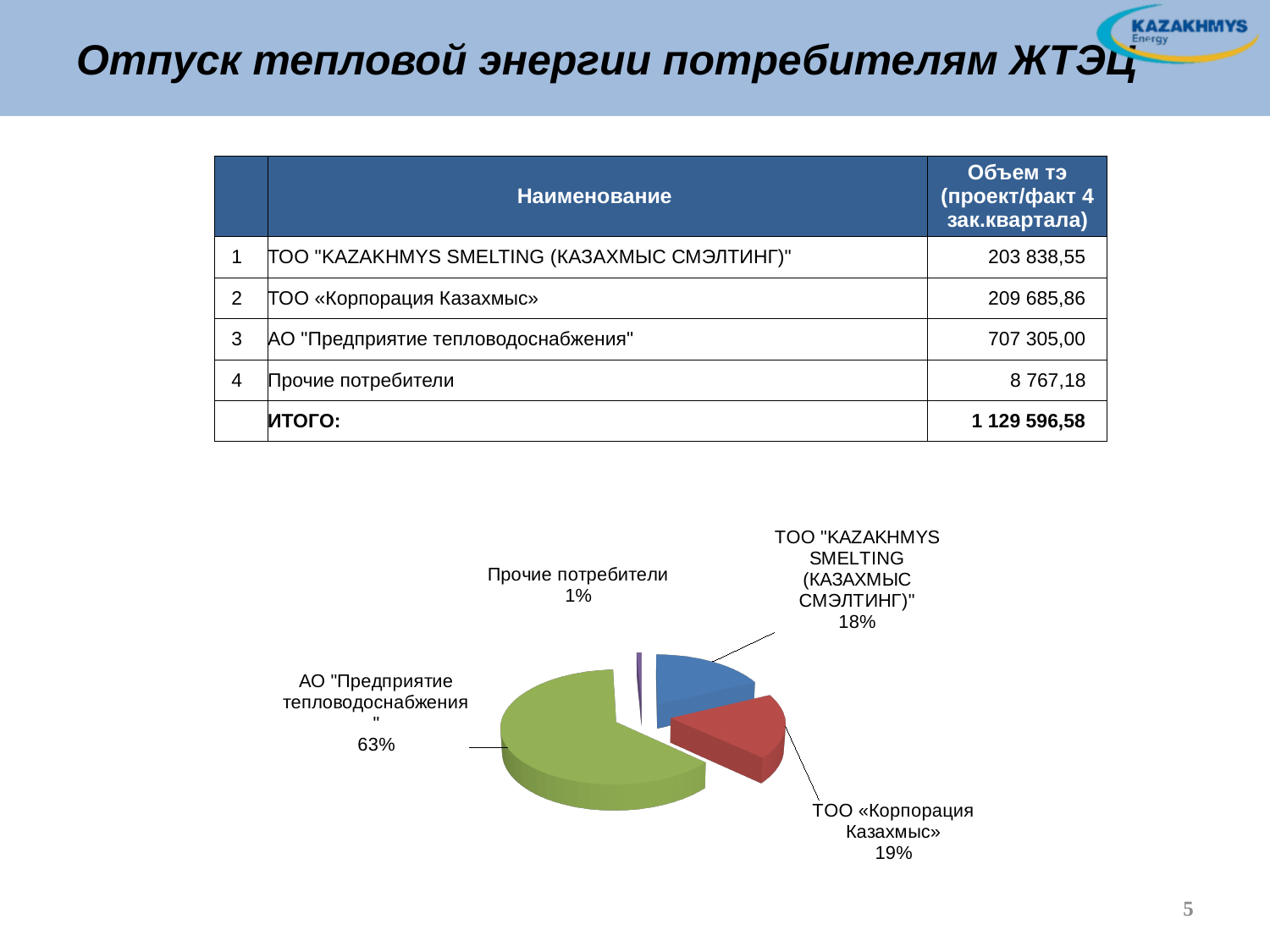
How many slices does the pie chart have? 4 What share of the pie does Прочие потребители have? 1% What share of the pie does АО "Предприятие тепловодоснабжения" have? 63% What share of the pie does ТОО "KAZAKHMYS SMELTING (КАЗАХМЫС СМЭЛТИНГ)" have? 18% What colour is the slice for АО "Предприятие тепловодоснабжения" in the pie chart? green What kind of chart is shown on the slide? pie chart Which has a larger share of the pie: ТОО «Корпорация Казахмыс» or ТОО "KAZAKHMYS SMELTING (КАЗАХМЫС СМЭЛТИНГ)"? ТОО «Корпорация Казахмыс» Which category has the smallest slice of the pie chart? Прочие потребители What is the difference in percentage points between the share of АО "Предприятие тепловодоснабжения" and the share of ТОО «Корпорация Казахмыс»? 44 Which category has the largest slice of the pie chart? АО "Предприятие тепловодоснабжения" What colour is the slice for ТОО «Корпорация Казахмыс» in the pie chart? red